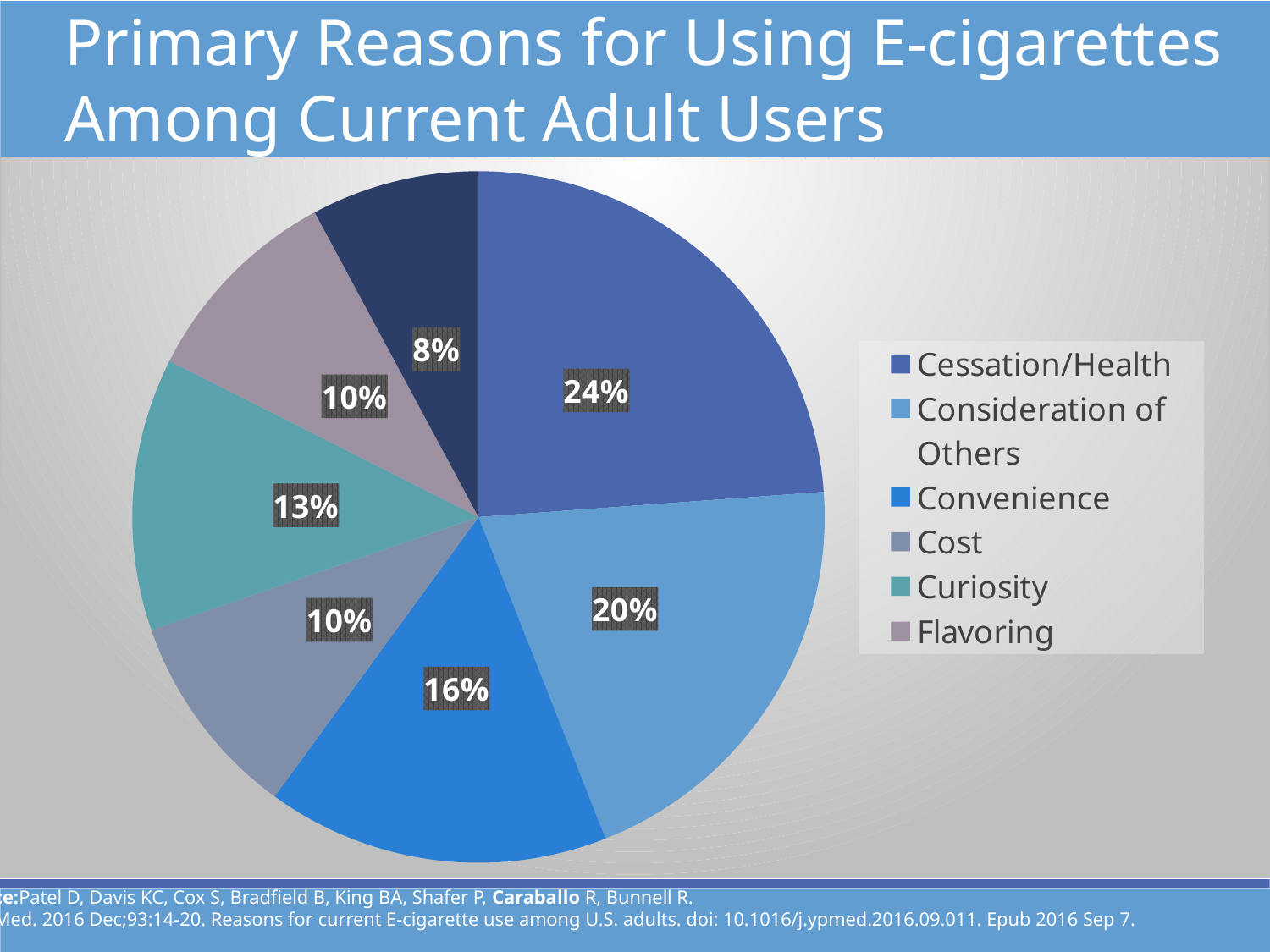
How many entries does the legend list? 6 What percentage is shown for Curiosity? 13% Which reason has the largest share of the pie? Cessation/Health What percentage is shown for Flavoring? 10% What type of chart is shown on the slide? Pie chart What percentage of current adult users cite Cessation/Health as their primary reason for using e-cigarettes? 24% Which is larger, the share for Curiosity or the share for Cost? Curiosity How many slices does the pie chart have? 7 What is the smallest percentage labelled on any slice of the pie? 8% What percentage is shown for Consideration of Others? 20% How many percentage points larger is the Cessation/Health slice than the Consideration of Others slice? 4 percentage points What percentage is shown for Convenience? 16%